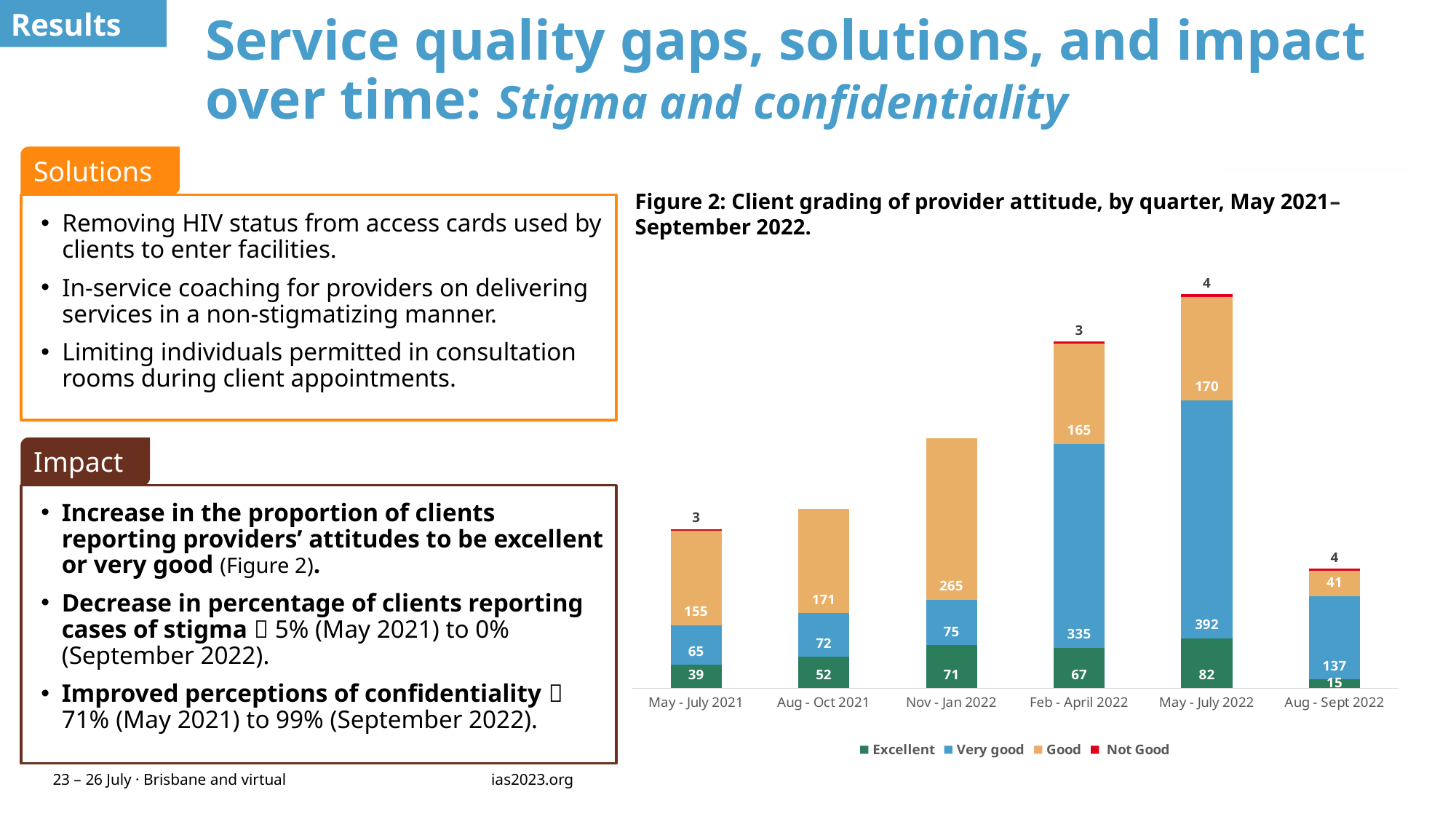
What is the difference between the 'Good' values for Aug - Oct 2021 and May - July 2021? 16 What is the total of the stacked bar for May - July 2022? 648 Which is larger: the 'Very good' value for Feb - April 2022 or for Nov - Jan 2022? Feb - April 2022 What is the 'Good' value for Nov - Jan 2022? 265 How many series does the legend of Figure 2 list? 4 What is the 'Very good' value for May - July 2022? 392 What type of chart is shown in Figure 2? Stacked bar chart Which quarter has the lowest 'Excellent' value? Aug - Sept 2022 What is the 'Excellent' value for Aug - Oct 2021? 52 Which quarter has the highest 'Very good' value? May - July 2022 What is the 'Not Good' value for Aug - Sept 2022? 4 How many quarters (categories) are shown on the x axis of Figure 2? 6